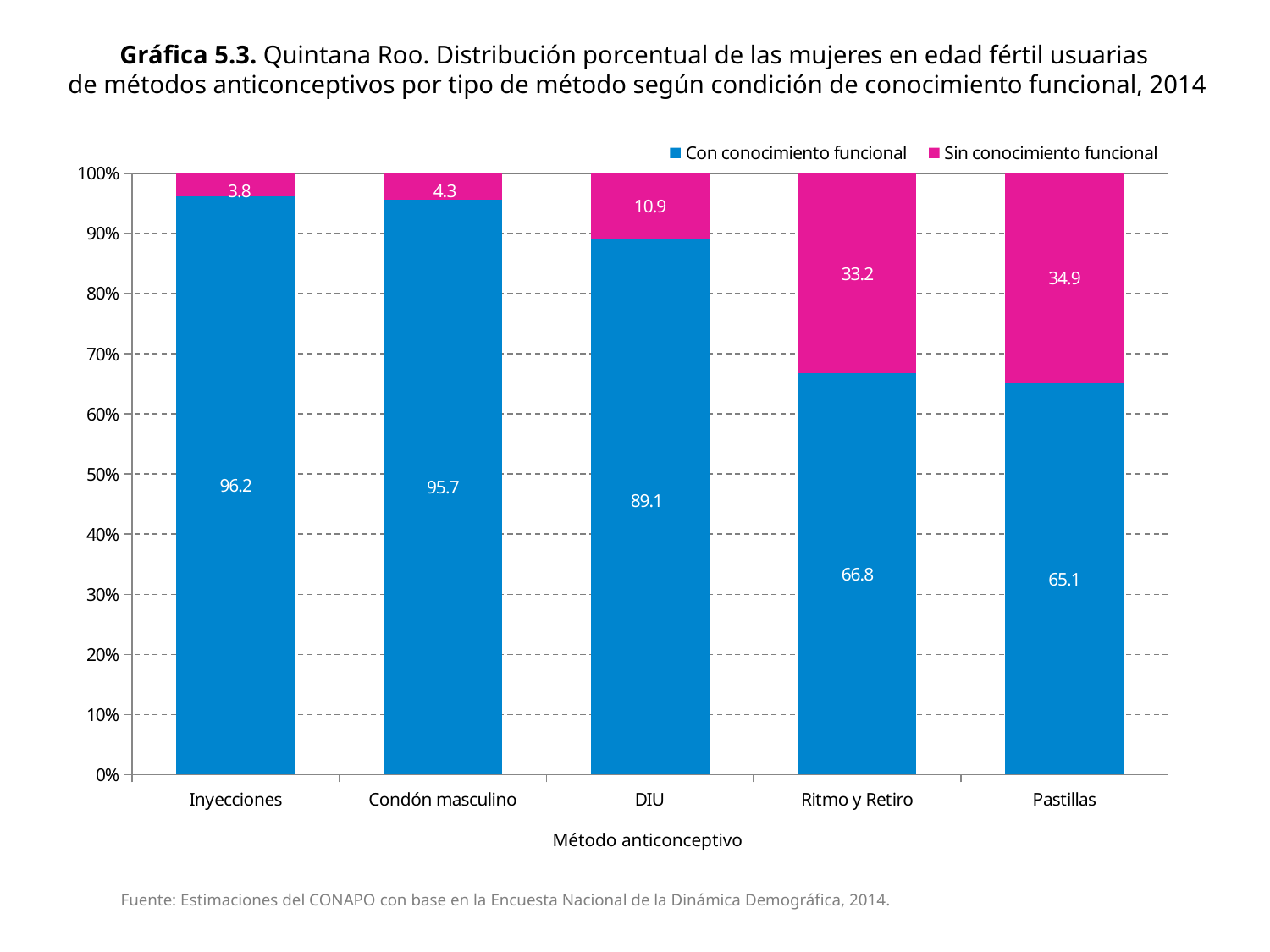
Which method has the lowest value for "Con conocimiento funcional"? Pastillas What is the value for "Con conocimiento funcional" for Inyecciones? 96.2 What is the total of the stacked bar for Ritmo y Retiro? 100 Which method has the highest value for "Sin conocimiento funcional"? Pastillas Which method has the highest value for "Con conocimiento funcional"? Inyecciones How many contraceptive methods are shown on the x axis? 5 Which is larger: the "Sin conocimiento funcional" value for Condón masculino or for DIU? DIU What kind of chart is shown on the slide? Stacked bar chart What is the value for "Sin conocimiento funcional" for DIU? 10.9 What is the difference between the "Con conocimiento funcional" values for DIU and Ritmo y Retiro? 22.3 What is the value for "Sin conocimiento funcional" for Pastillas? 34.9 How many series does the legend list? 2